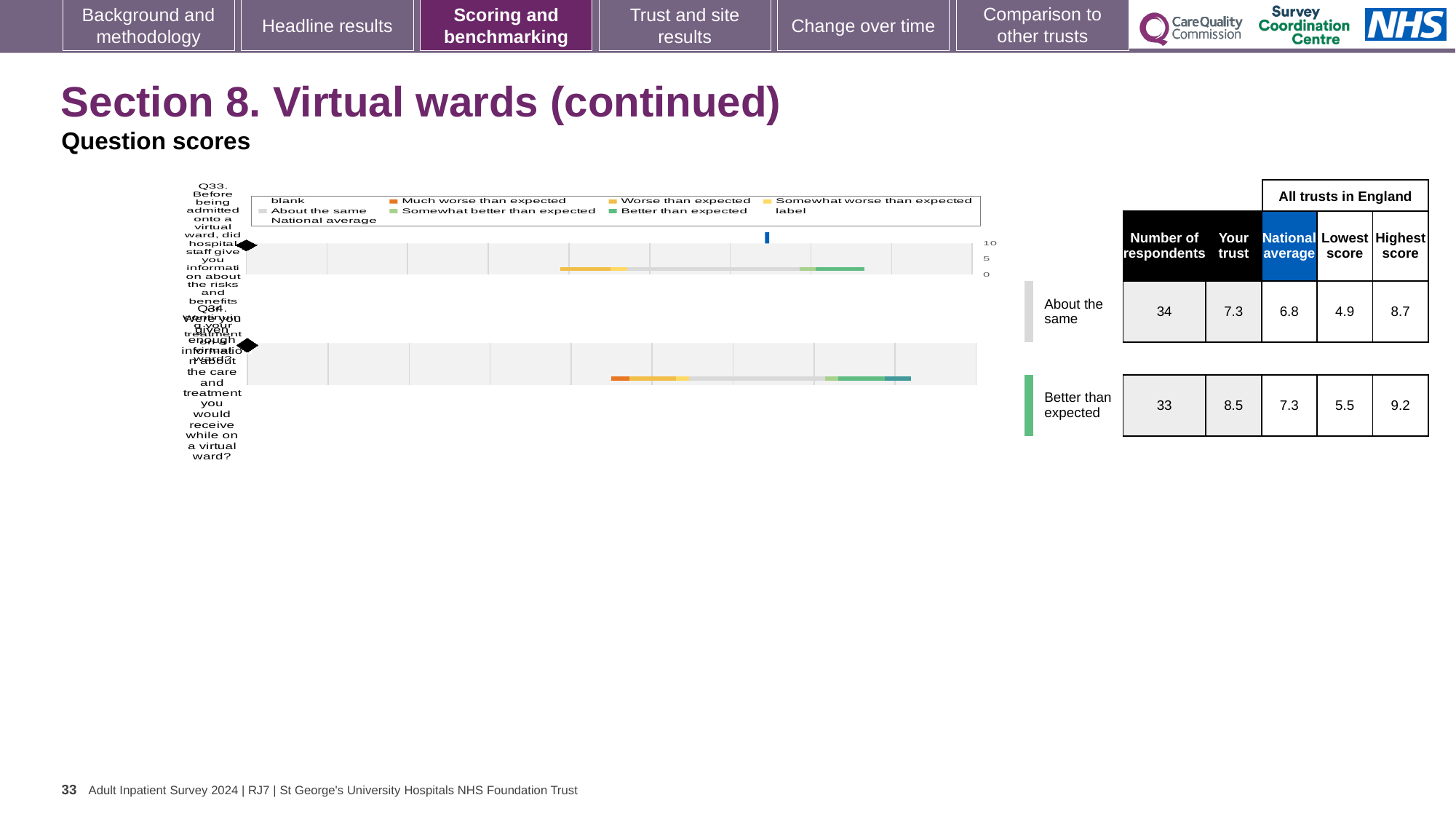
How many questions (categories) are plotted in the chart? 2 What is the difference between the lowest scores for Q34 and Q33? 0.6 Which benchmark category is Q34 placed in? Better than expected What is the national average score for Q33? 6.8 What kind of chart is used to show the question scores on this slide? bar chart What is the 'Your trust' score for Q33 (information about the risks and benefits of a virtual ward)? 7.3 What is the 'Your trust' score for Q34 (enough information about the care and treatment on a virtual ward)? 8.5 What is the difference between the 'Your trust' score and the national average for Q34? 1.2 How many respondents answered Q33? 34 Which question has the higher 'Your trust' score, Q33 or Q34? Q34 What is the highest score among all trusts in England for Q34? 9.2 Which benchmark category is Q33 placed in? About the same